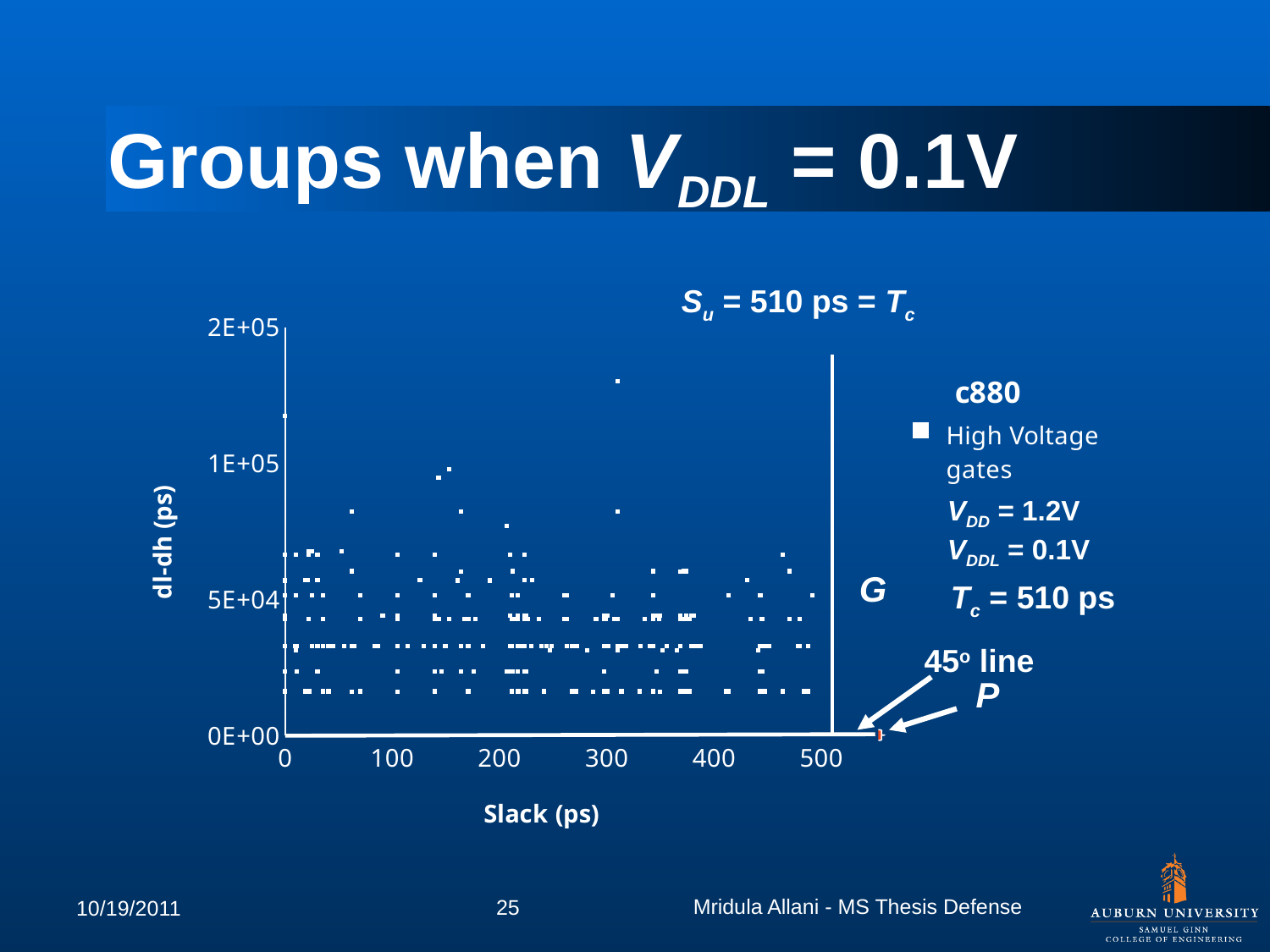
What is the highest value labelled on the chart's y axis? 2E+05 What kind of chart is shown on the slide? scatter chart What is the name of the series listed in the chart legend? High Voltage gates What value of Tc is stated next to the chart? 510 ps How many series does the chart legend list? 1 Is the dl-dh value of the lowest row of plotted points greater or less than 5E+04? less What value of VDD is stated next to the chart? 1.2V Is the dl-dh value of the topmost plotted point greater or less than 1E+05? greater What is the label of the chart's y axis? dl-dh (ps) What is the highest value labelled on the chart's x axis? 500